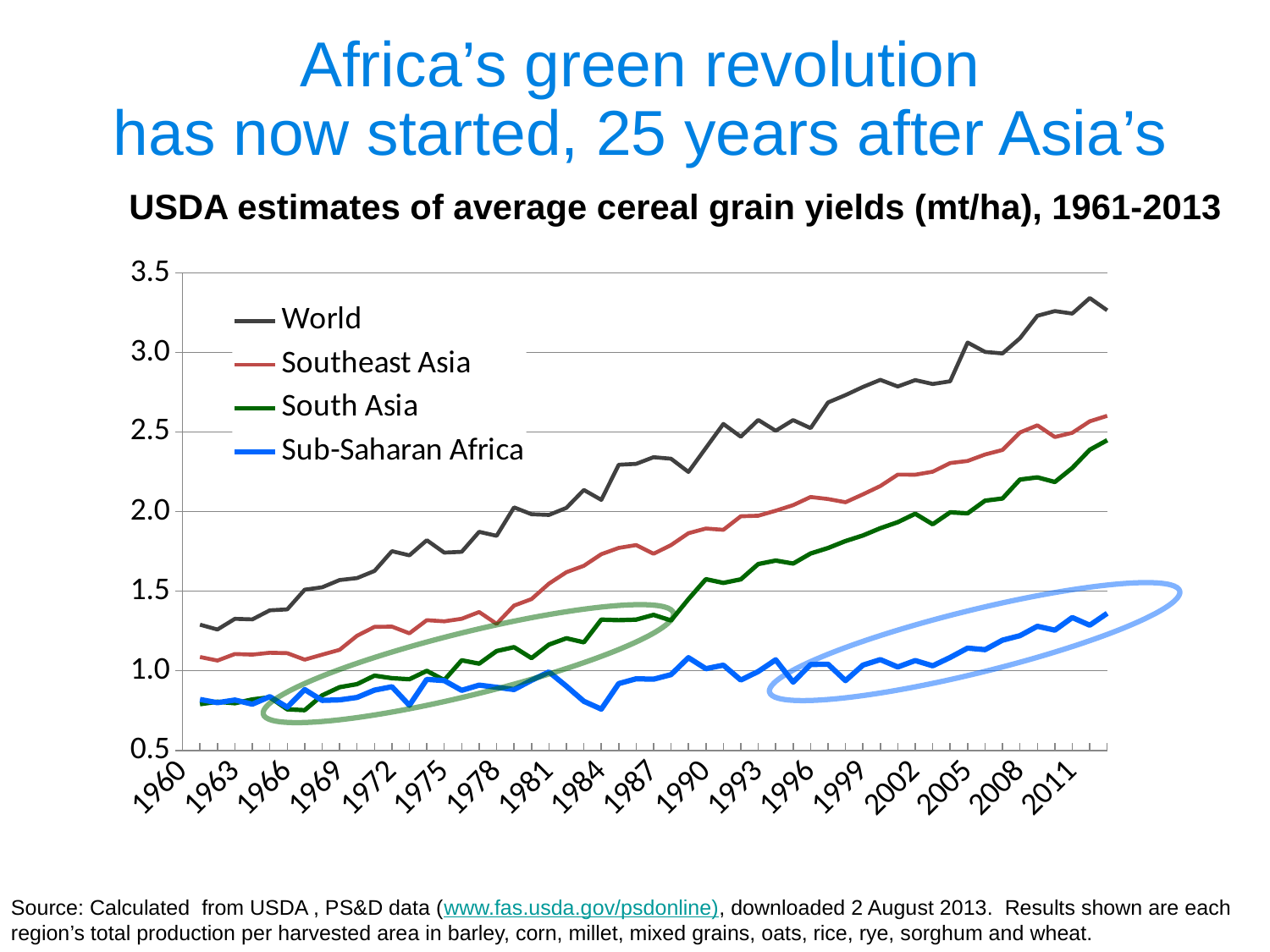
Which series has the lowest value at the right end of the chart (2011 onward)? Sub-Saharan Africa Is the value for South Asia in 2011 greater or less than 2.0? greater Is the value for Sub-Saharan Africa in 2011 greater or less than 1.5? less What is the title of the chart? USDA estimates of average cereal grain yields (mt/ha), 1961-2013 Which series are listed in the chart legend? World, Southeast Asia, South Asia, Sub-Saharan Africa Is the value for World in 2011 greater or less than 3.0? greater Does the World series generally rise or fall from 1960 to 2011? rise In 1975, which is larger: the value for Southeast Asia or the value for South Asia? Southeast Asia What kind of chart is shown on the slide? line chart Which series has the highest value at the right end of the chart (2011 onward)? World How many series does the chart legend list? 4